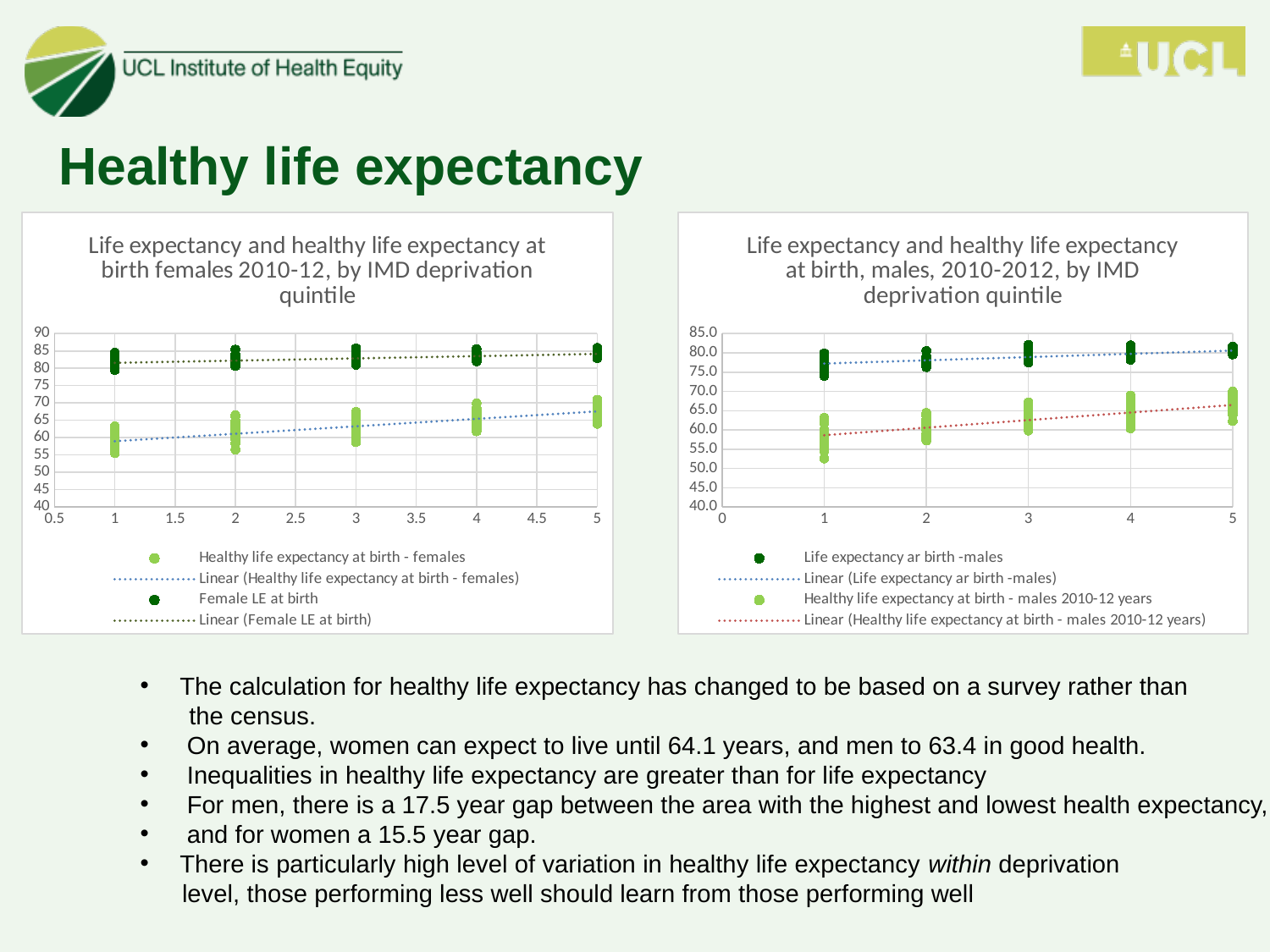
What kind of chart is the left chart, 'Life expectancy and healthy life expectancy at birth females 2010-12, by IMD deprivation quintile'? Scatter chart In the left chart (females), does healthy life expectancy at birth rise or fall as the deprivation quintile increases from 1 to 5? Rise In the right chart (males), how many deprivation quintiles are plotted along the x axis? 5 In the left chart (females), are the healthy life expectancy at birth values at quintile 1 greater or less than 70? less In the right chart (males), are the healthy life expectancy at birth values at quintile 1 greater or less than 70.0? less In the left chart (females), are the Female LE at birth values at quintile 1 greater or less than 75? greater How many entries does the legend of the right chart (males) list? 4 How many entries does the legend of the left chart (females) list? 4 In the right chart (males), does the linear trend for healthy life expectancy at birth rise or fall from quintile 1 to quintile 5? Rise In the right chart (males), which series is plotted higher on the y axis: Life expectancy at birth or healthy life expectancy at birth? Life expectancy at birth What is the title of the right chart? Life expectancy and healthy life expectancy at birth, males, 2010-2012, by IMD deprivation quintile